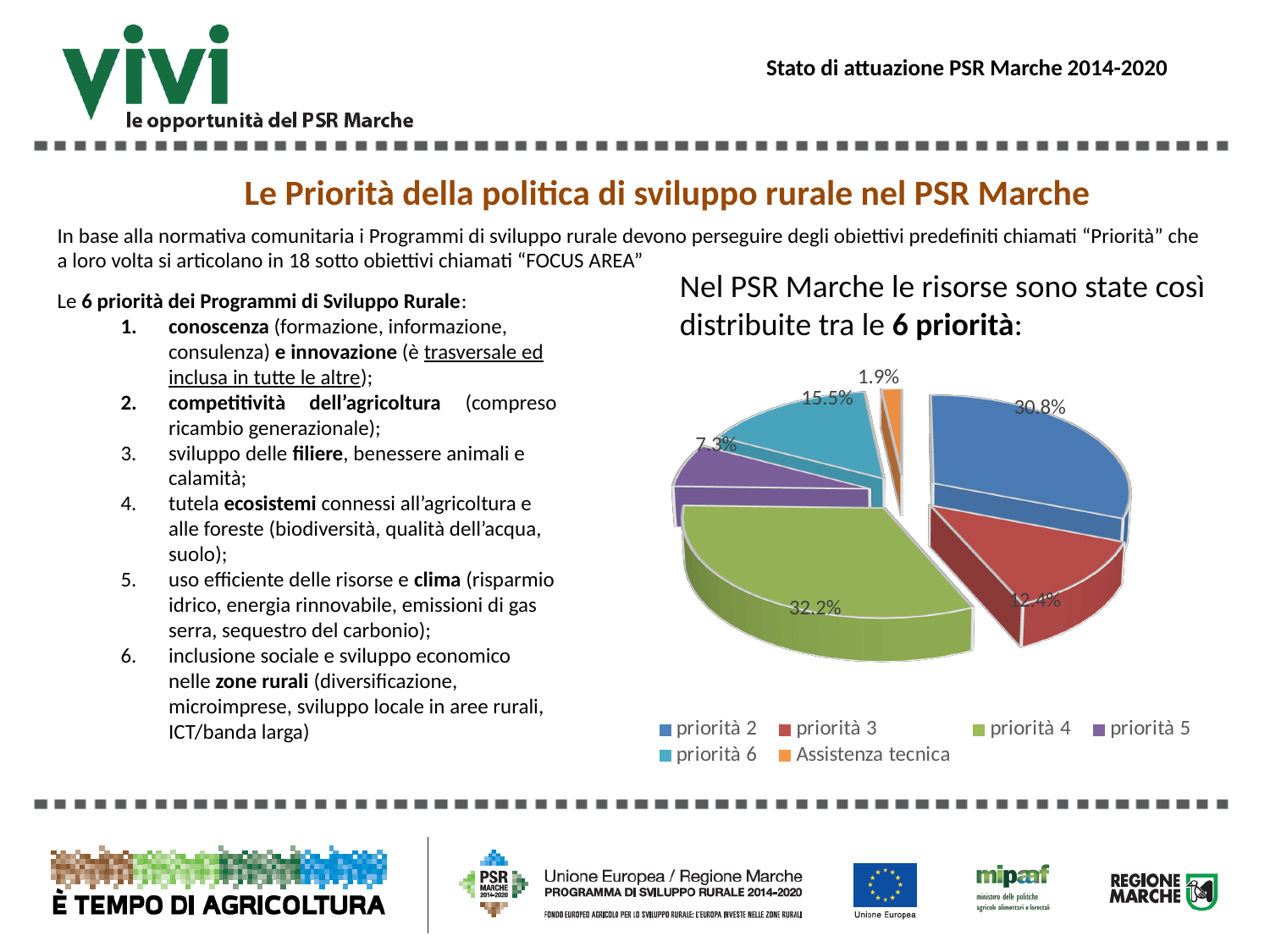
What share of the pie does priorità 4 have? 32.2% Which has a larger share, priorità 3 or priorità 6? priorità 6 What share of the pie does priorità 2 have? 30.8% Which slice of the pie is the largest? priorità 4 How many slices does the pie chart have? 6 Which slice of the pie is the smallest? Assistenza tecnica What share of the pie does priorità 6 have? 15.5% What share of the pie does priorità 3 have? 12.4% How many entries does the legend list? 6 What share of the pie does Assistenza tecnica have? 1.9% What is the difference between the shares of priorità 6 and priorità 5? 8.2% What kind of chart is shown on the slide? pie chart